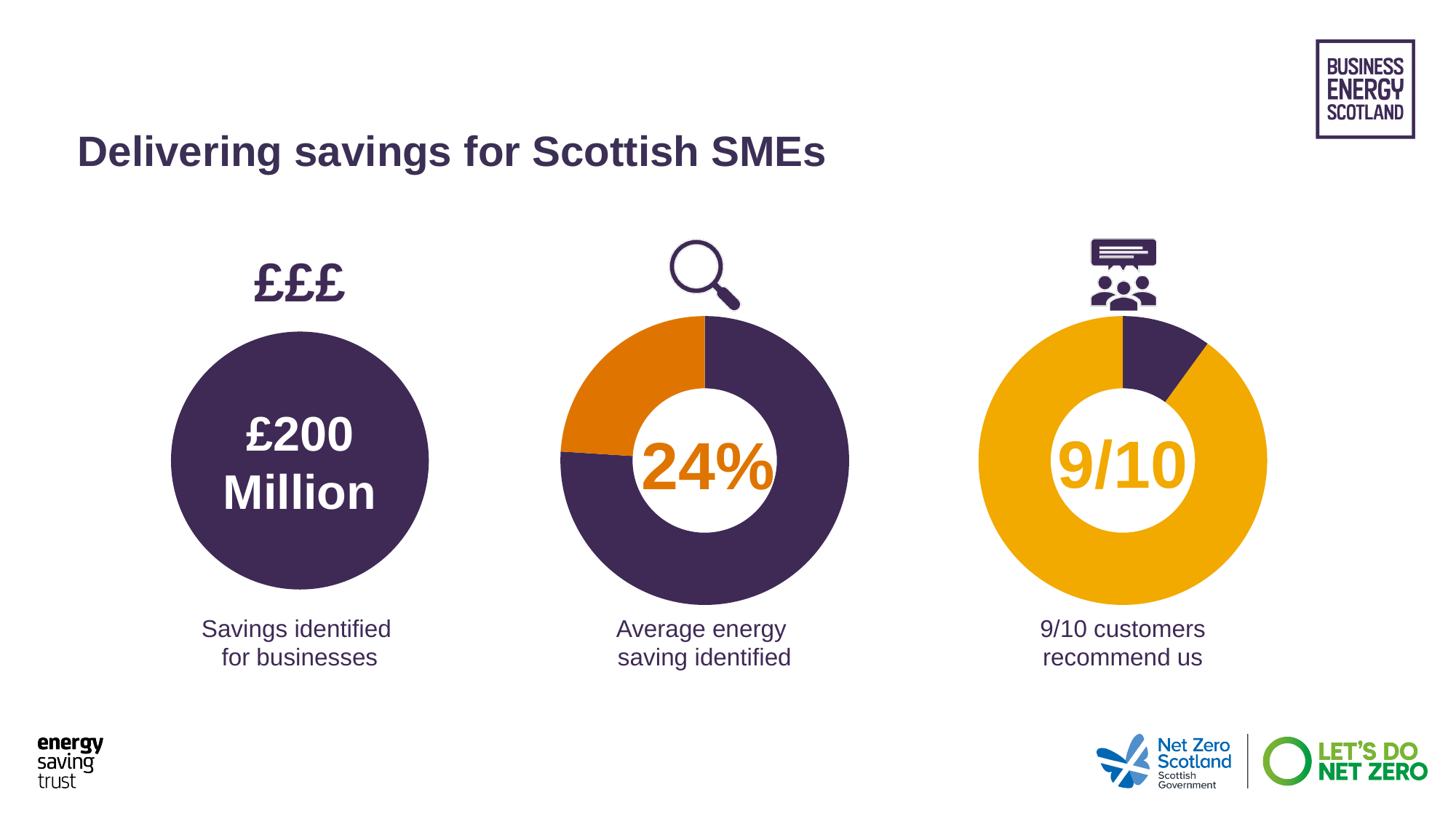
On the middle chart, what share of the ring does the purple segment represent? 76% What kind of chart is the middle chart showing the average energy saving identified? Donut (pie) chart How many segments does the right-hand donut chart have? 2 What is the title of the slide containing these charts? Delivering savings for Scottish SMEs On the right-hand chart, which colour segment is larger, the yellow or the purple? Yellow On the right-hand chart labelled '9/10 customers recommend us', what value is shown in the centre? 9/10 On the right-hand chart, what share of the ring does the yellow segment represent? 9/10 On the middle chart, what share of the ring does the orange segment represent? 24% How many segments does the middle donut chart have? 2 What value is shown in the left-hand circle labelled 'Savings identified for businesses'? £200 Million On the middle chart, which colour segment is larger, the orange or the purple? Purple On the middle chart labelled 'Average energy saving identified', what value is shown in the centre? 24%